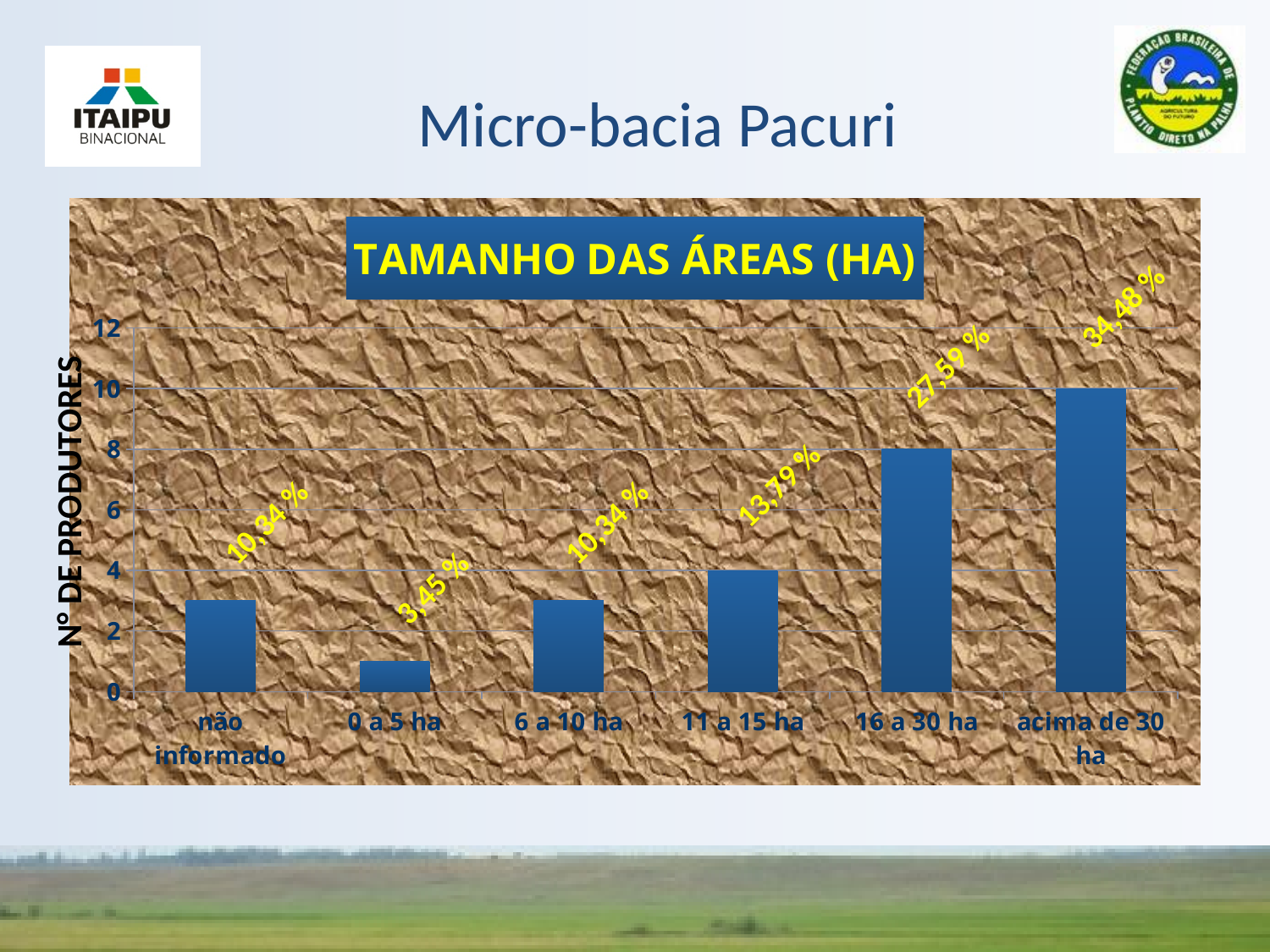
How many categories are shown on the x axis? 6 How many producers are in the '16 a 30 ha' category? 8 Which category has the lowest number of producers? 0 a 5 ha What percentage label is shown for the '0 a 5 ha' category? 3,45 % What is the label of the vertical axis? Nº DE PRODUTORES What kind of chart is shown on the slide? bar chart How many producers are in the 'acima de 30 ha' category? 10 Is the number of producers for 'não informado' greater or less than 4? less What is the difference in number of producers between 'acima de 30 ha' and '16 a 30 ha'? 2 Which category has the highest number of producers? acima de 30 ha What percentage label is shown for the '11 a 15 ha' category? 13,79 % What is the title of the chart? TAMANHO DAS ÁREAS (HA)